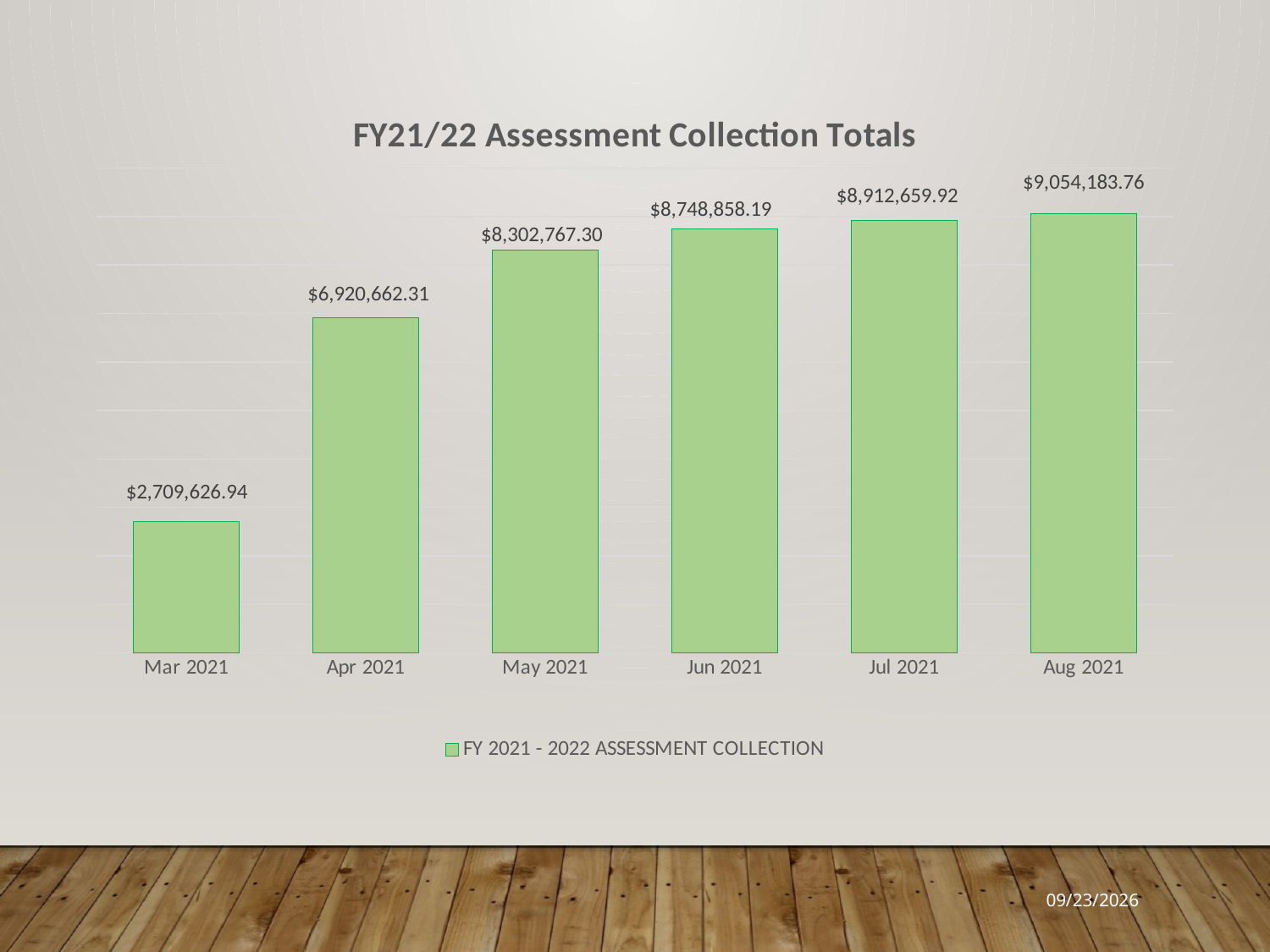
Which is larger, the value for May 2021 or the value for Apr 2021? May 2021 What is the difference between the values for Aug 2021 and Jul 2021? $141,523.84 What is the value for Mar 2021? $2,709,626.94 How many series does the legend list? 1 Do the values rise or fall from Mar 2021 to Aug 2021? Rise What is the value for Jun 2021? $8,748,858.19 Which month has the lowest assessment collection total? Mar 2021 What is the value for Aug 2021? $9,054,183.76 What kind of chart is shown? Bar chart Which month has the highest assessment collection total? Aug 2021 What is the difference between the values for Apr 2021 and Mar 2021? $4,211,035.37 How many months are shown on the chart? 6